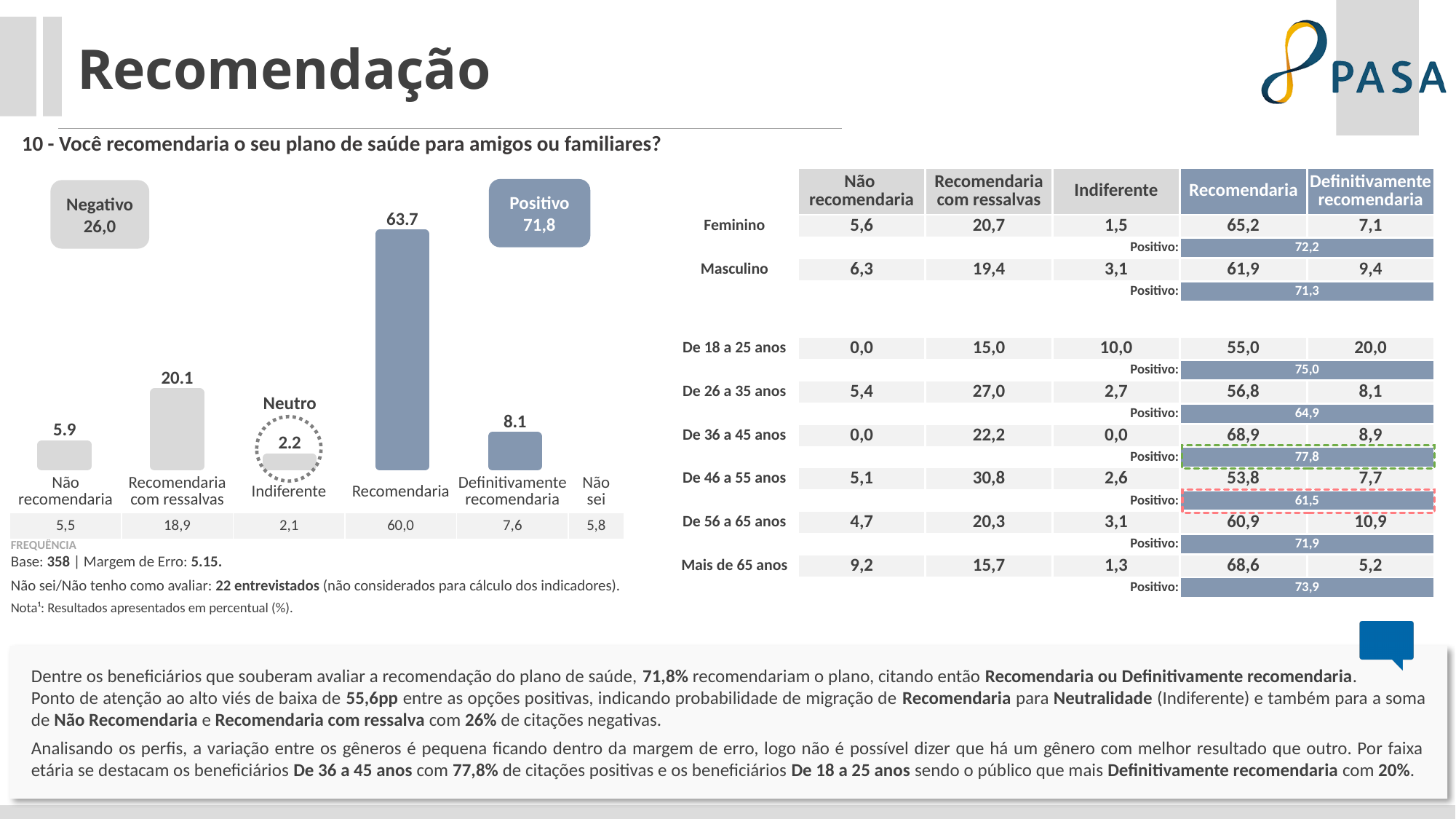
What is the Negativo total shown in the chart's callout box? 26,0 What value is shown for Definitivamente recomendaria in the chart? 8.1 What value is shown for Indiferente in the chart? 2.2 Which is larger in the chart: Definitivamente recomendaria or Não recomendaria? Definitivamente recomendaria What value is shown for Recomendaria com ressalvas in the chart? 20.1 What value is shown for the Não recomendaria bar in the chart? 5.9 What is the difference between the Recomendaria value and the Recomendaria com ressalvas value in the chart? 43.6 What value is shown for the Recomendaria bar in the chart? 63.7 What type of chart is shown on the left of the slide? Bar chart Which category has the highest bar in the chart? Recomendaria Which category has the lowest bar in the chart? Indiferente What is the Positivo total shown in the chart's callout box? 71,8